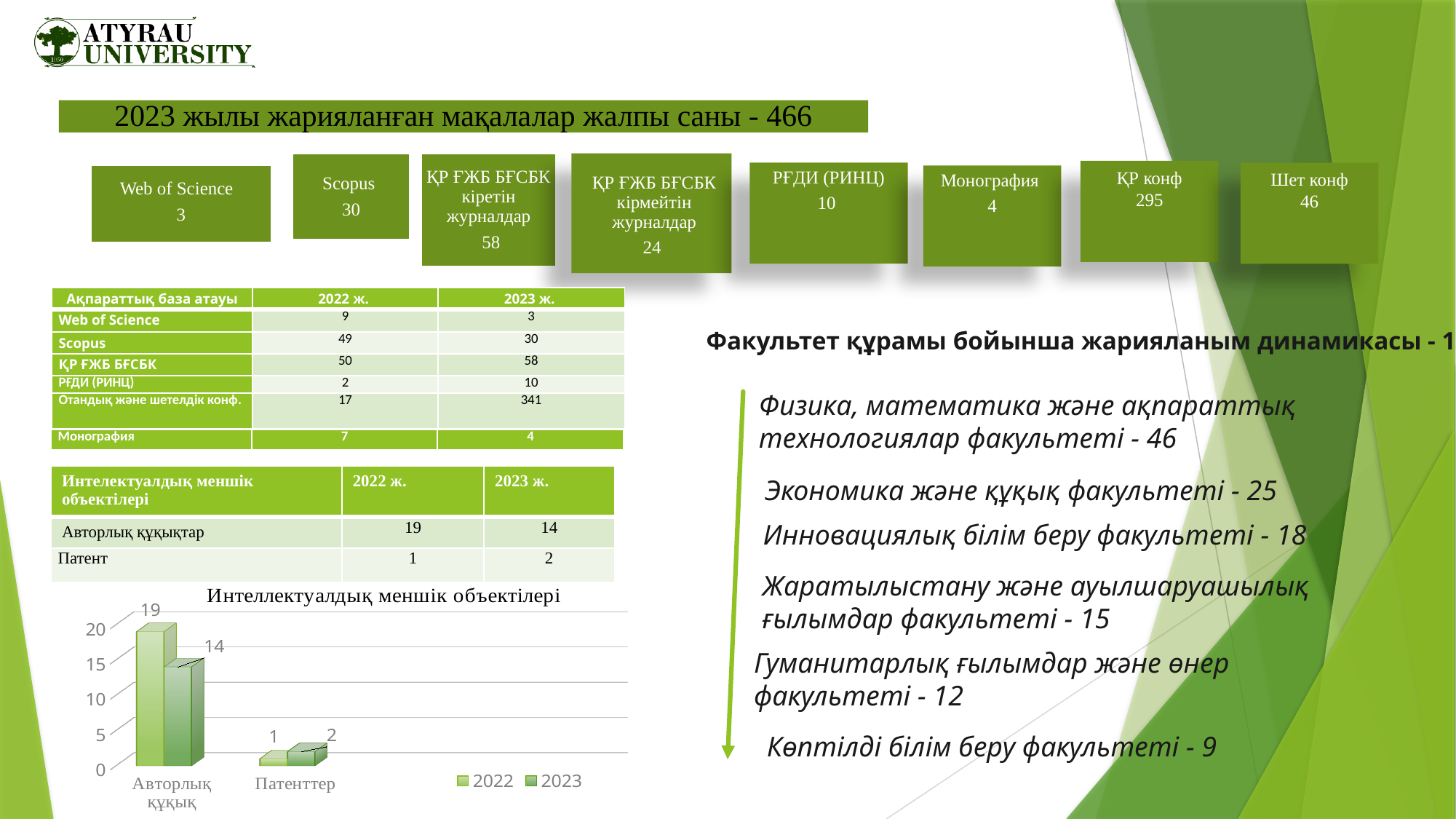
What is the title of the chart on the slide? Интеллектуалдық меншік объектілері What is the 2023 value for Патенттер in the chart? 2 Which category has the highest value in the chart? Авторлық құқық What is the 2022 value for Патенттер in the chart? 1 What type of chart is shown on the slide? bar chart What is the difference between the 2022 and 2023 values for Авторлық құқық? 5 Which is larger for Патенттер: the 2022 value or the 2023 value? 2023 How many series does the chart legend list? 2 What is the 2023 value for Авторлық құқық in the chart? 14 Is the 2023 value for Авторлық құқық greater or less than 10? greater What is the 2022 value for Авторлық құқық in the chart? 19 How many categories are shown on the x axis of the chart? 2